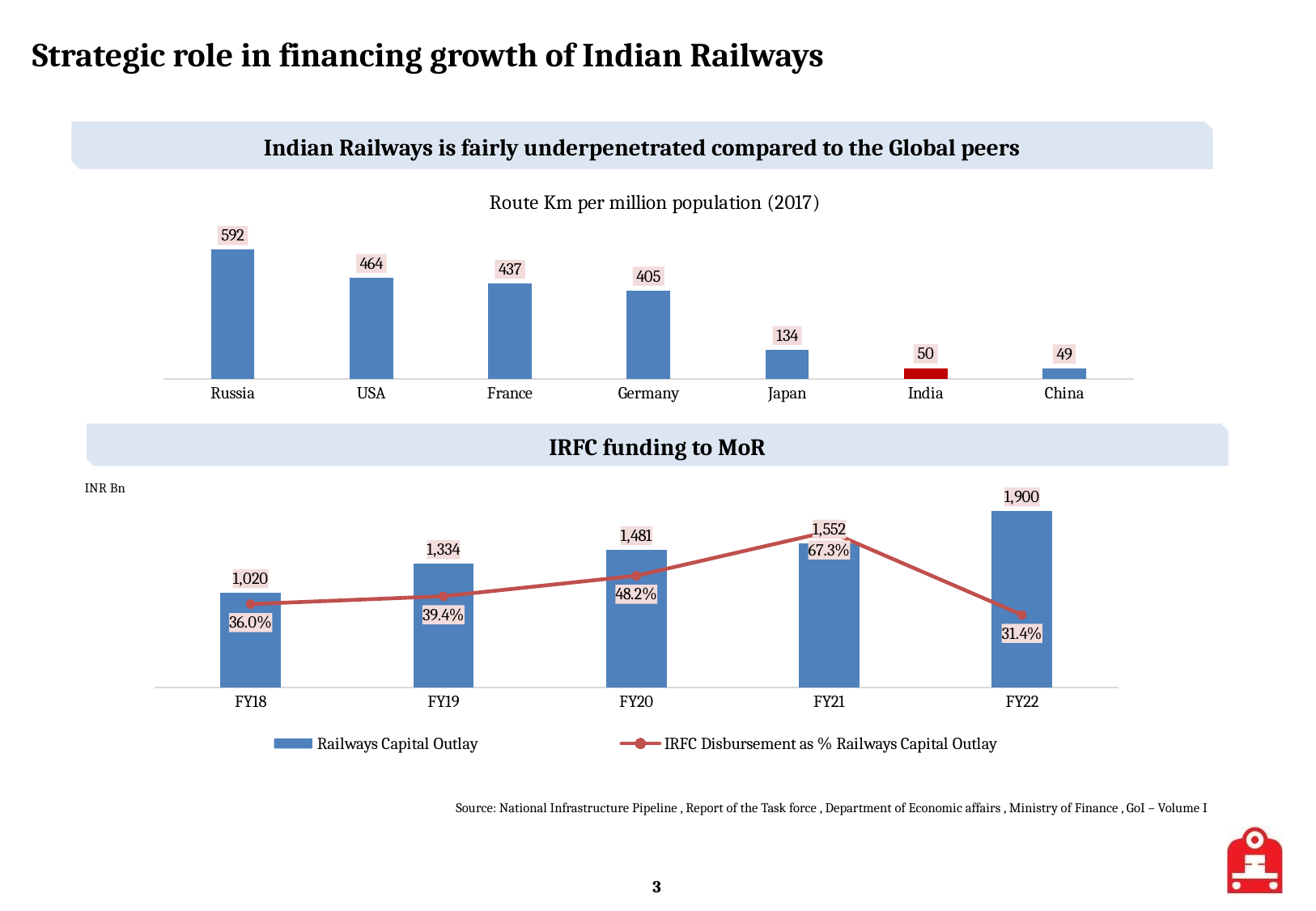
In the 'Route Km per million population (2017)' chart, what is the value for Russia? 592 In the 'IRFC funding to MoR' chart, how many series does the legend list? 2 In the 'IRFC funding to MoR' chart, what is the difference in Railways Capital Outlay between FY22 and FY18? 880 In the 'Route Km per million population (2017)' chart, which bar is coloured red? India In the 'IRFC funding to MoR' chart, which year has the highest Railways Capital Outlay? FY22 In the 'IRFC funding to MoR' chart, does the Railways Capital Outlay rise or fall from FY18 to FY22? rise In the 'IRFC funding to MoR' chart, what is the IRFC Disbursement as % Railways Capital Outlay for FY21? 67.3% In the 'Route Km per million population (2017)' chart, how many countries are shown? 7 What type of chart is the 'Route Km per million population (2017)' chart? bar chart In the 'Route Km per million population (2017)' chart, which country has the lowest value? China In the 'IRFC funding to MoR' chart, what is the Railways Capital Outlay for FY20? 1,481 In the 'Route Km per million population (2017)' chart, what is the difference between the values for USA and France? 27